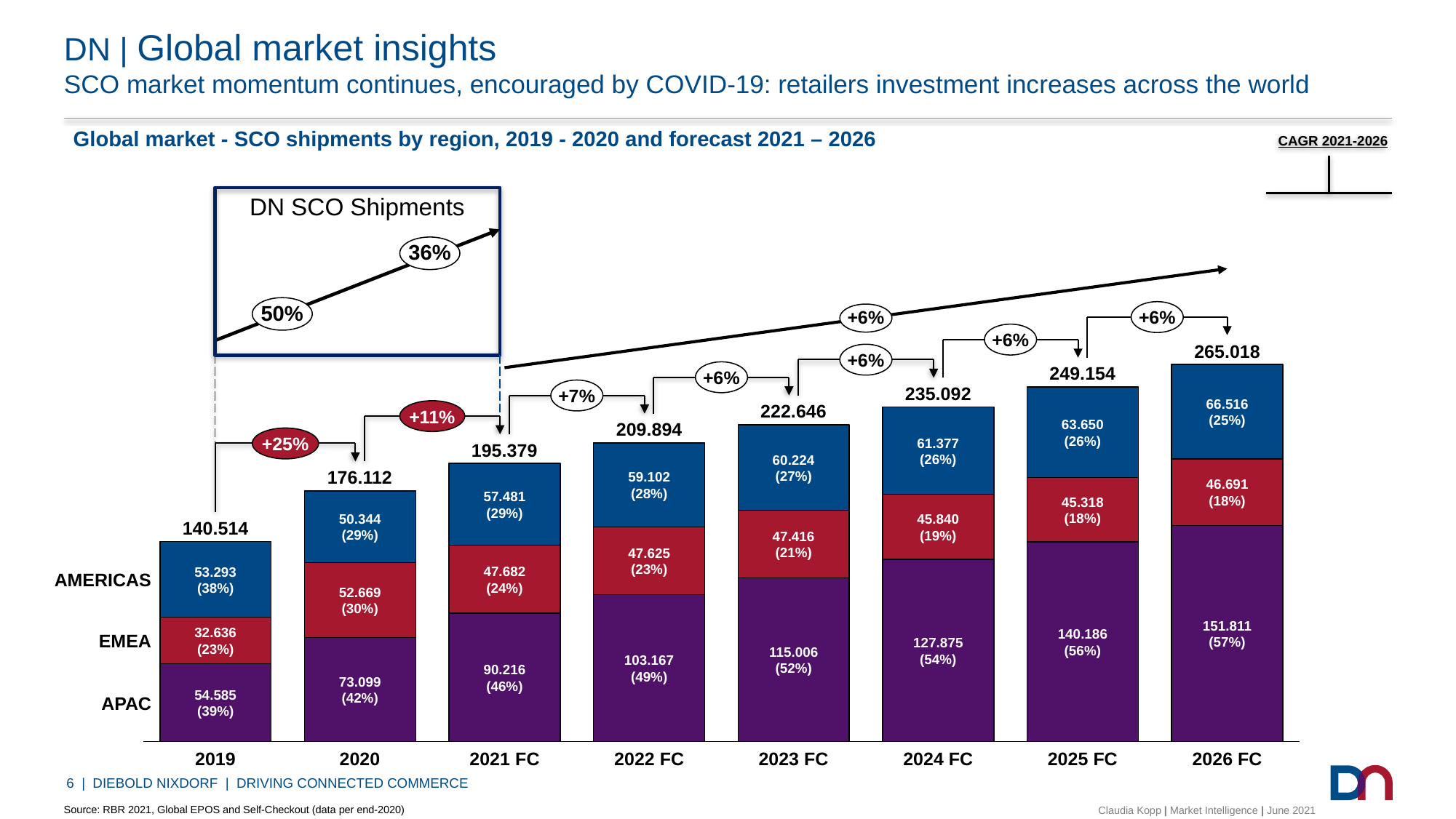
What is the total of the stacked bar for 2021 FC? 195.379 In 2020, which is larger: the EMEA value or the AMERICAS value? EMEA How many years are shown on the x axis? 8 What is the AMERICAS value for 2026 FC? 66.516 What kind of chart is shown? Stacked bar chart Which year has the highest total SCO shipments? 2026 FC What is the APAC value for 2019? 54.585 What growth percentage is shown between 2019 and 2020? +25% What is the difference between the total for 2026 FC and the total for 2019? 124.504 Which year has the lowest total SCO shipments? 2019 What is the EMEA value for 2023 FC? 47.416 How many regions are stacked in each bar? 3